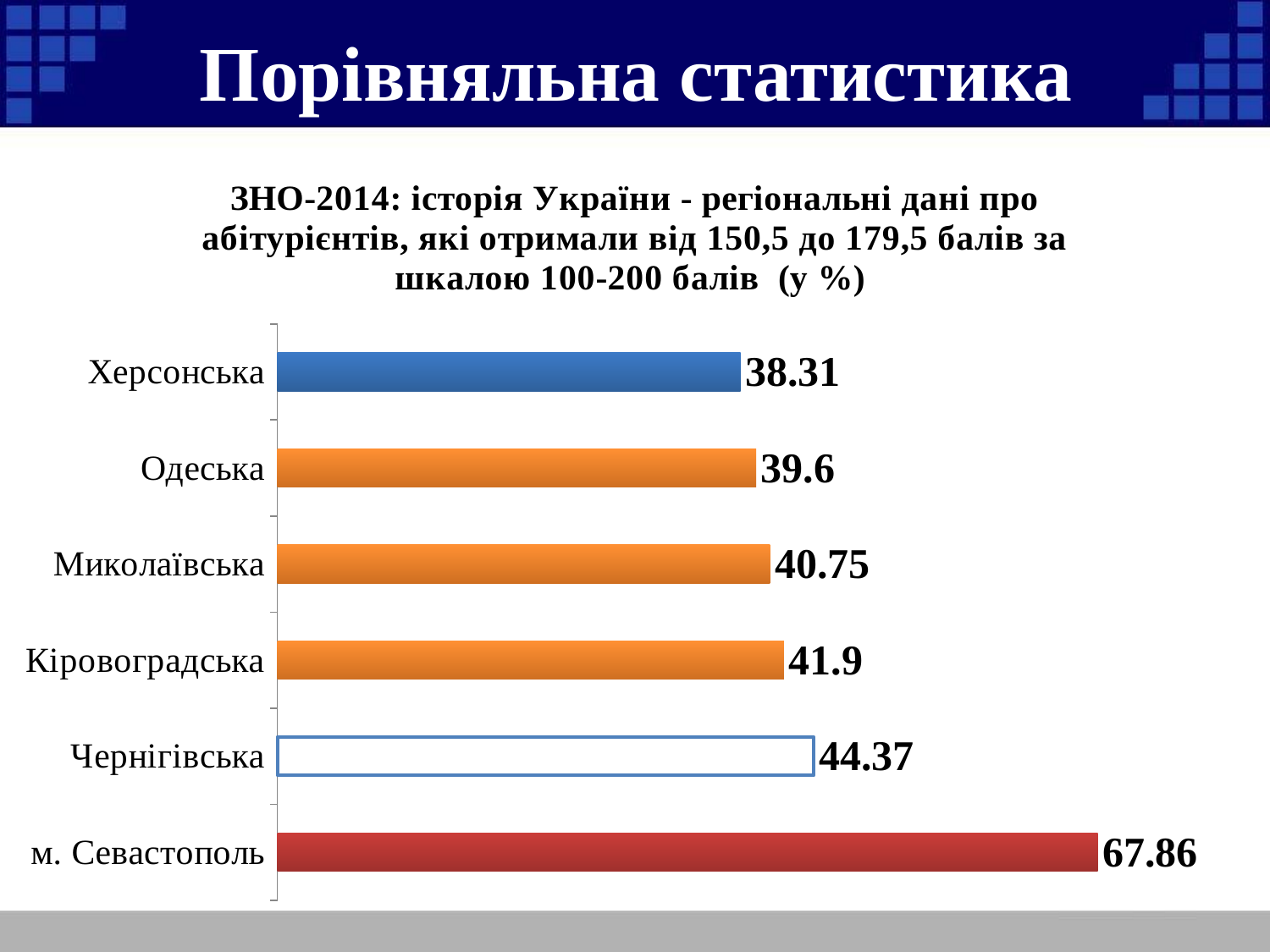
Do the values increase or decrease going from the top bar to the bottom bar? Increase What is the value for Херсонська? 38.31 How many regions are shown in the chart? 6 Which has a larger value, Одеська or Кіровоградська? Кіровоградська What is the value for Чернігівська? 44.37 What is the value for Миколаївська? 40.75 What kind of chart is shown on the slide? Bar chart Which region has the lowest value? Херсонська What is the difference between the values for Кіровоградська and Херсонська? 3.59 What is the value for м. Севастополь? 67.86 Which region has the highest value? м. Севастополь What is the difference between the values for м. Севастополь and Чернігівська? 23.49